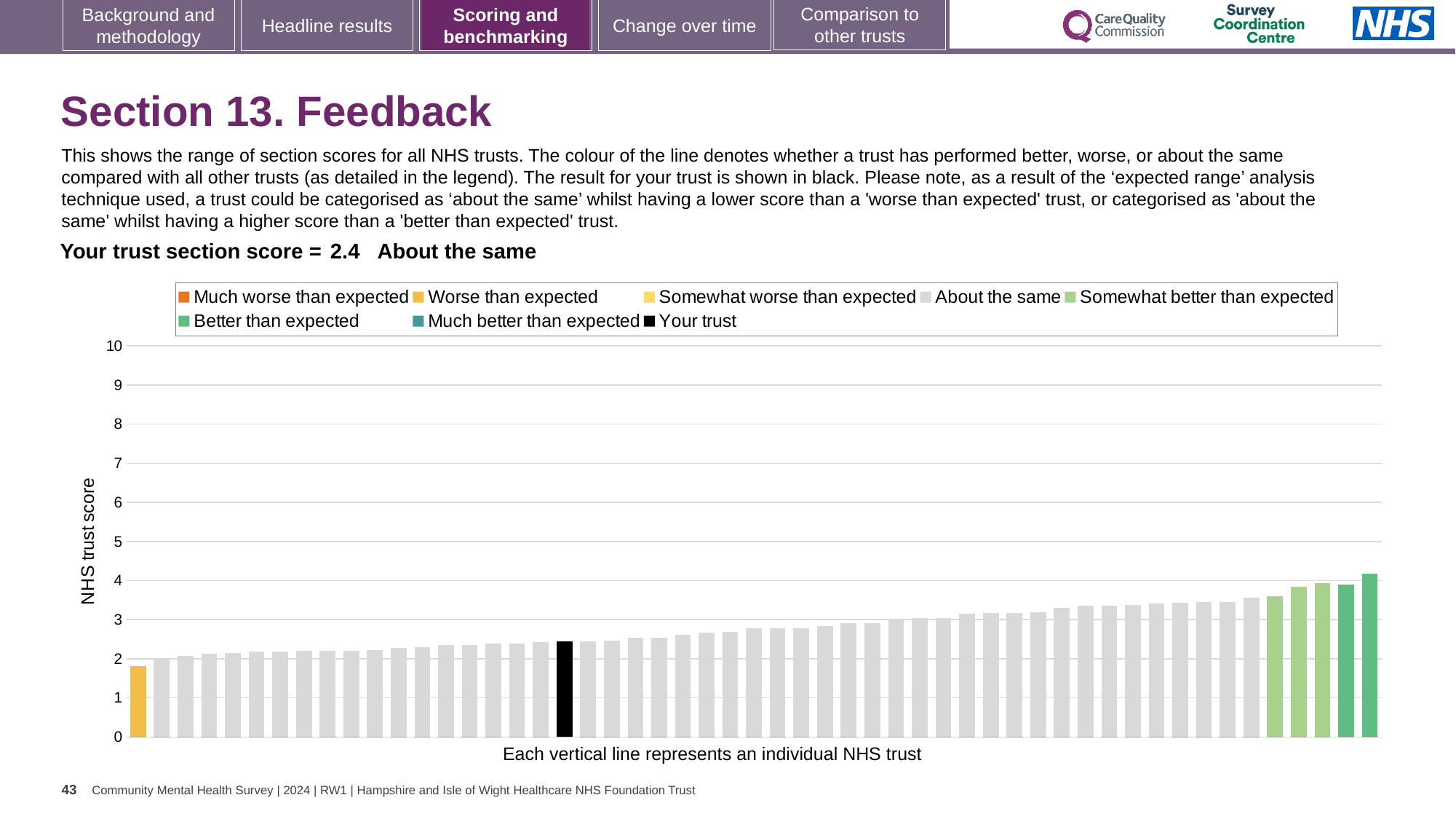
How is your trust's section score categorised compared with other trusts? About the same What is the label on the vertical axis of the chart? NHS trust score What is the maximum value shown on the vertical axis? 10 Is the leftmost bar higher or lower than the rightmost bar? Lower Do the bar values rise or fall moving from left to right across the chart? Rise Is your trust's section score greater or less than 3? less What is your trust's section score for Section 13. Feedback? 2.4 What kind of chart is shown on the slide? Bar chart How many entries does the chart legend list? 8 What colour is the bar representing your trust? Black Is the value of the tallest bar greater or less than 4? greater Is the value of the leftmost (shortest) bar greater or less than 2? less